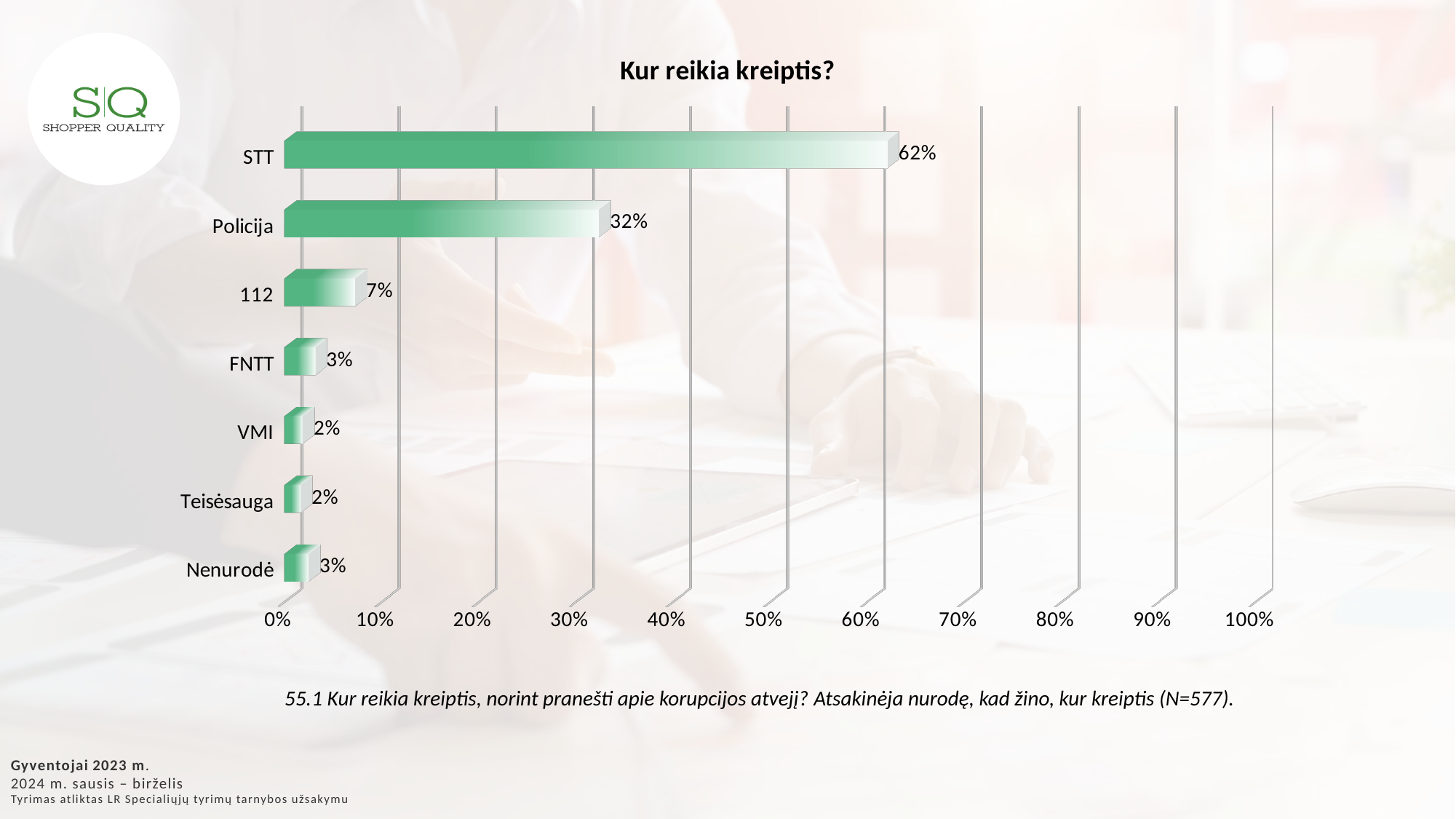
What is the value for 112? 7% What is the value for FNTT? 3% What is the value for STT? 62% How many categories are shown in the chart? 7 What is the title of the chart? Kur reikia kreiptis? Which is larger, the value for 112 or the value for FNTT? 112 What is the value for Policija? 32% Is the value for Policija greater or less than 40%? less What is the difference between the values for STT and Policija? 30% Which category has the highest value? STT What is the value for Nenurodė? 3% What kind of chart is shown on the slide? bar chart